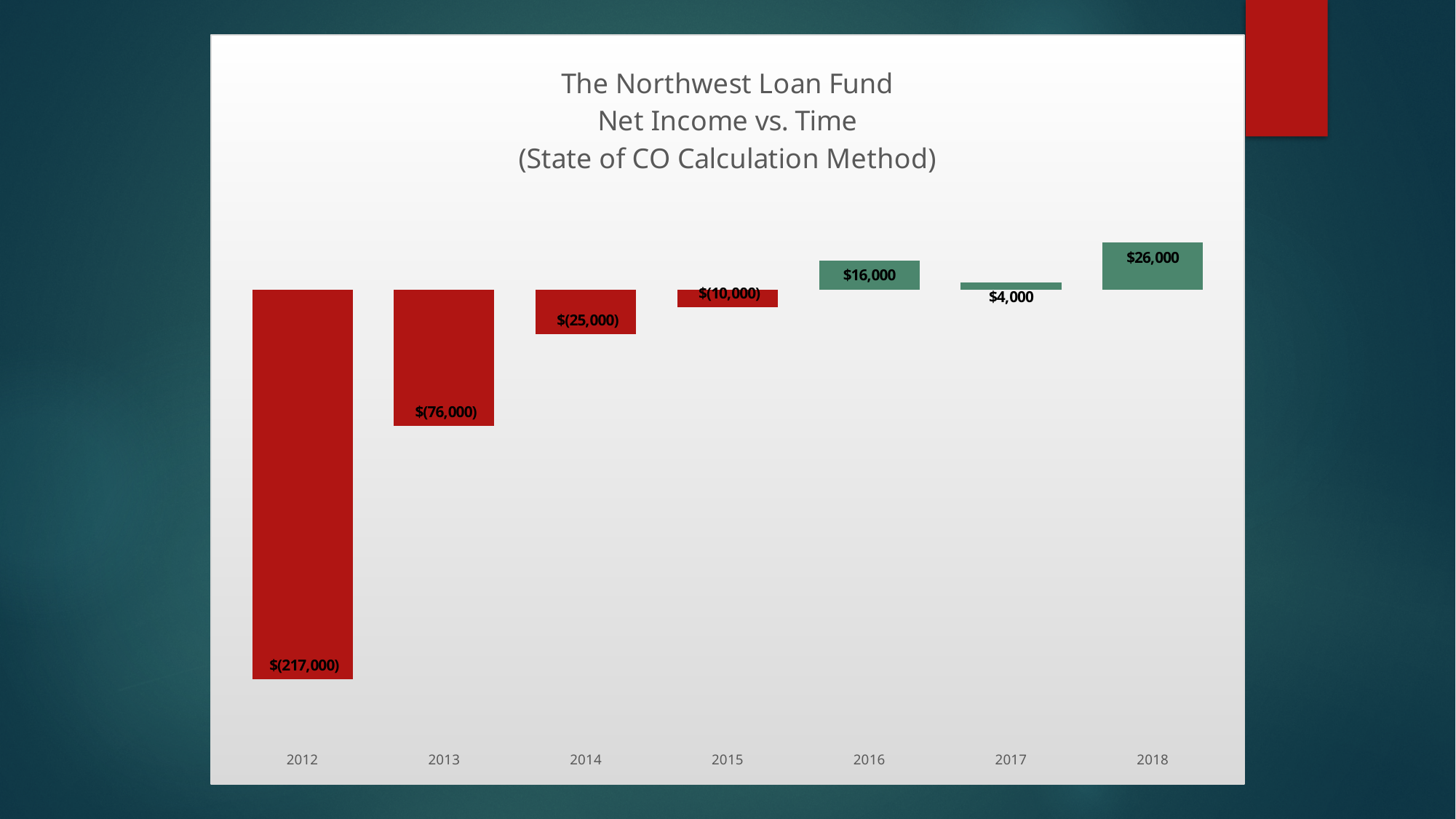
What is the net income value shown for 2012? $(217,000) How many years are shown on the x axis? 7 Which year has the lowest net income? 2012 What kind of chart is this? Bar chart Does net income generally rise or fall from 2012 to 2018? Rise What is the difference between the net income in 2018 and in 2016? $10,000 What colour are the bars for years with negative net income? Red Which year has the larger net income, 2013 or 2015? 2015 What is the net income value shown for 2016? $16,000 What is the net income value shown for 2014? $(25,000) Which year has the highest net income? 2018 What is the net income value shown for 2017? $4,000